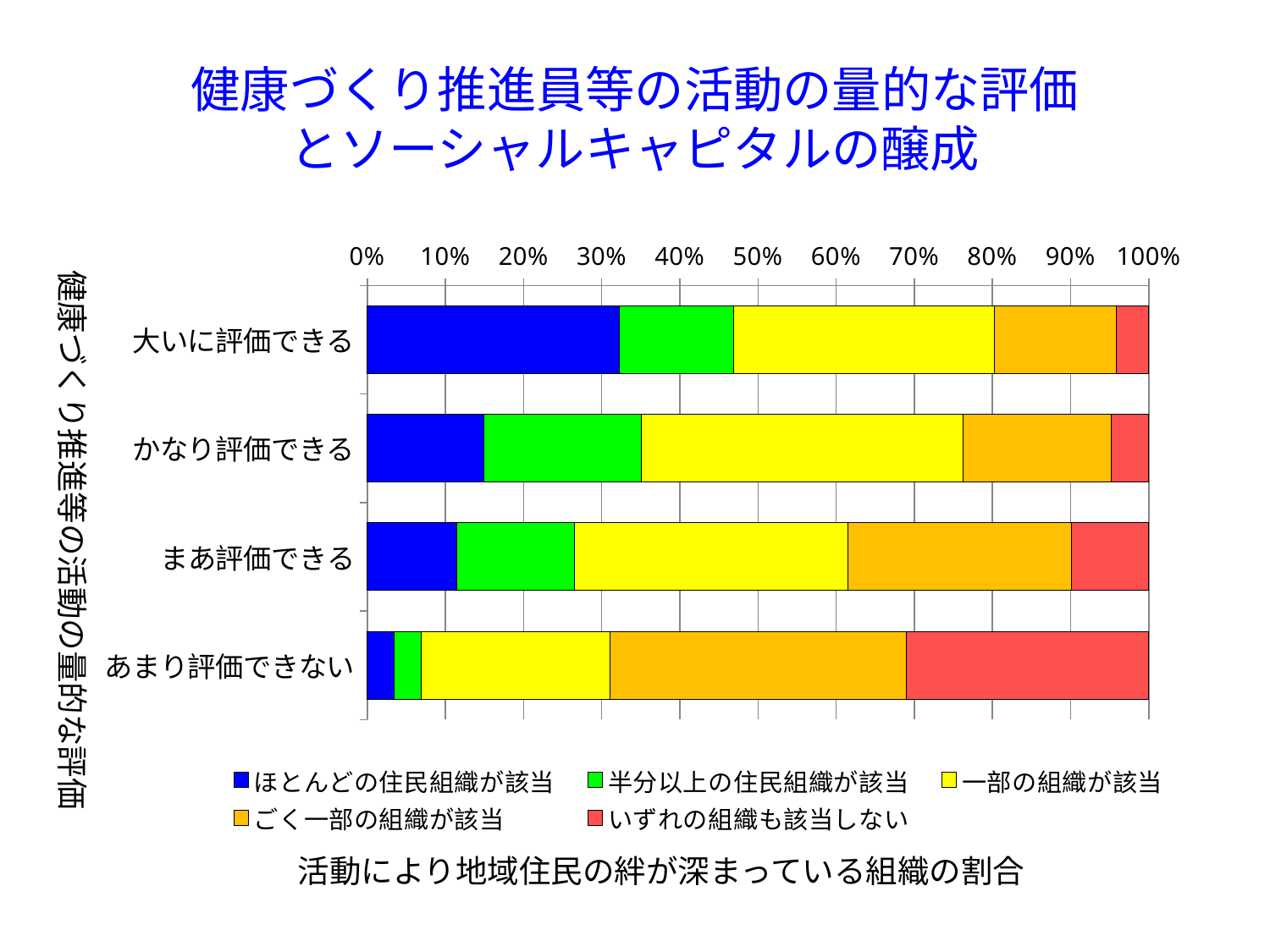
How many series does the legend list? 5 How many categories are shown on the vertical axis of the chart? 4 Is the 半分以上の住民組織が該当 share for あまり評価できない greater or less than 10%? less Which category has the smallest segment for ほとんどの住民組織が該当? あまり評価できない What kind of chart is shown on the slide? stacked bar chart Which has a larger ごく一部の組織が該当 segment: まあ評価できる or 大いに評価できる? まあ評価できる Which category has the largest segment for 一部の組織が該当? かなり評価できる Which category has the largest segment for いずれの組織も該当しない? あまり評価できない Is the ほとんどの住民組織が該当 share for 大いに評価できる greater or less than 20%? greater Which category has the largest segment for ほとんどの住民組織が該当? 大いに評価できる What is the title of the horizontal axis below the legend? 活動により地域住民の絆が深まっている組織の割合 Is the いずれの組織も該当しない share for あまり評価できない greater or less than 20%? greater